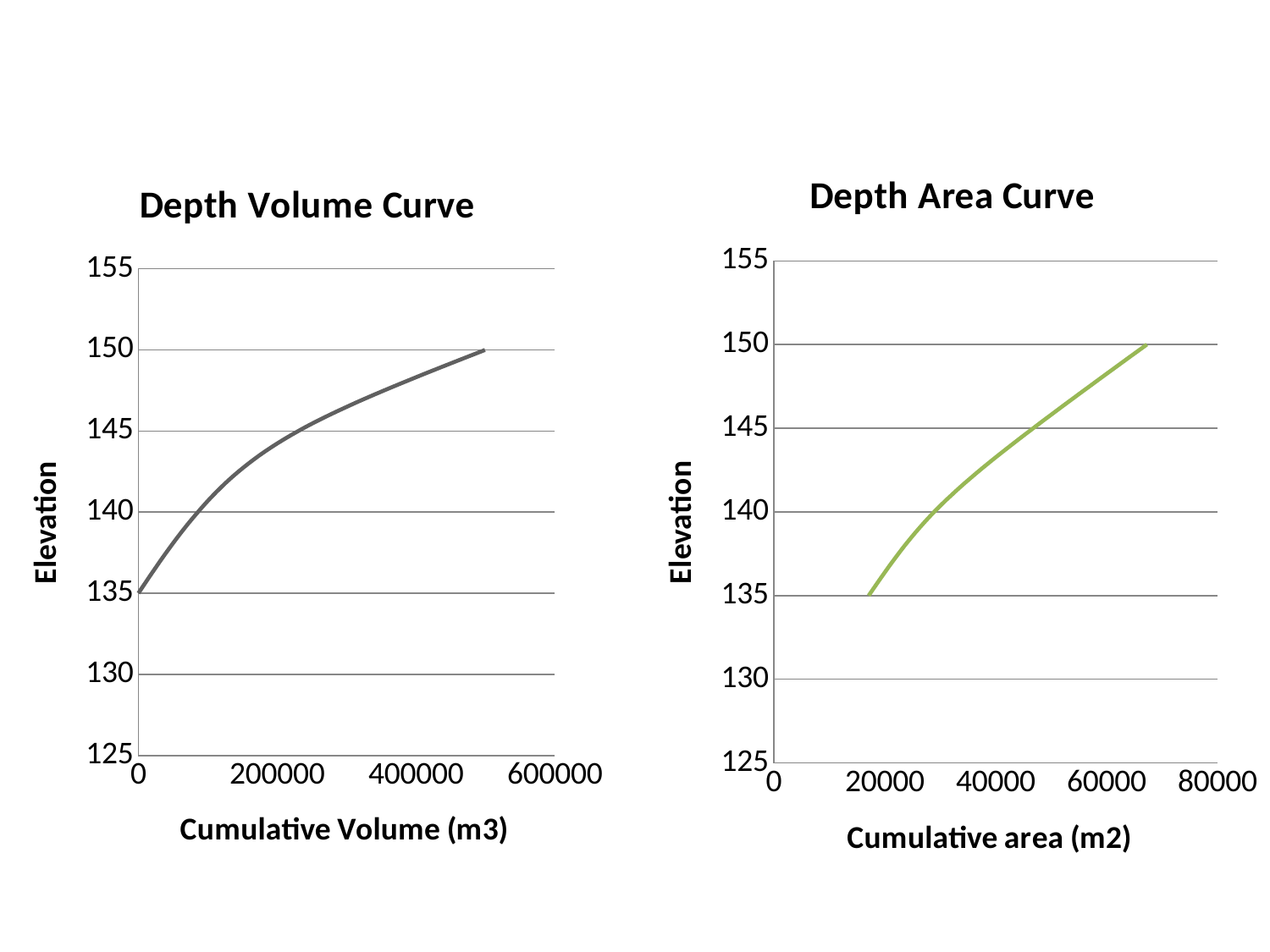
In the Depth Volume Curve, what is the elevation at a cumulative volume of 0? 135 In the Depth Volume Curve, what is the highest elevation the curve reaches? 150 In the Depth Volume Curve, is the cumulative volume at elevation 140 greater or less than 200000? less In the Depth Volume Curve, is the cumulative volume at elevation 150 greater or less than 400000? greater What kind of chart is the Depth Area Curve? line chart In the Depth Area Curve, is the cumulative area at elevation 140 greater or less than 40000? less In the Depth Area Curve, what is the lowest elevation the curve reaches? 135 In the Depth Volume Curve, does elevation rise or fall as cumulative volume increases? rise What is the x-axis label of the Depth Area Curve? Cumulative area (m2) What kind of chart is the Depth Volume Curve? line chart In the Depth Area Curve, does elevation rise or fall as cumulative area increases? rise